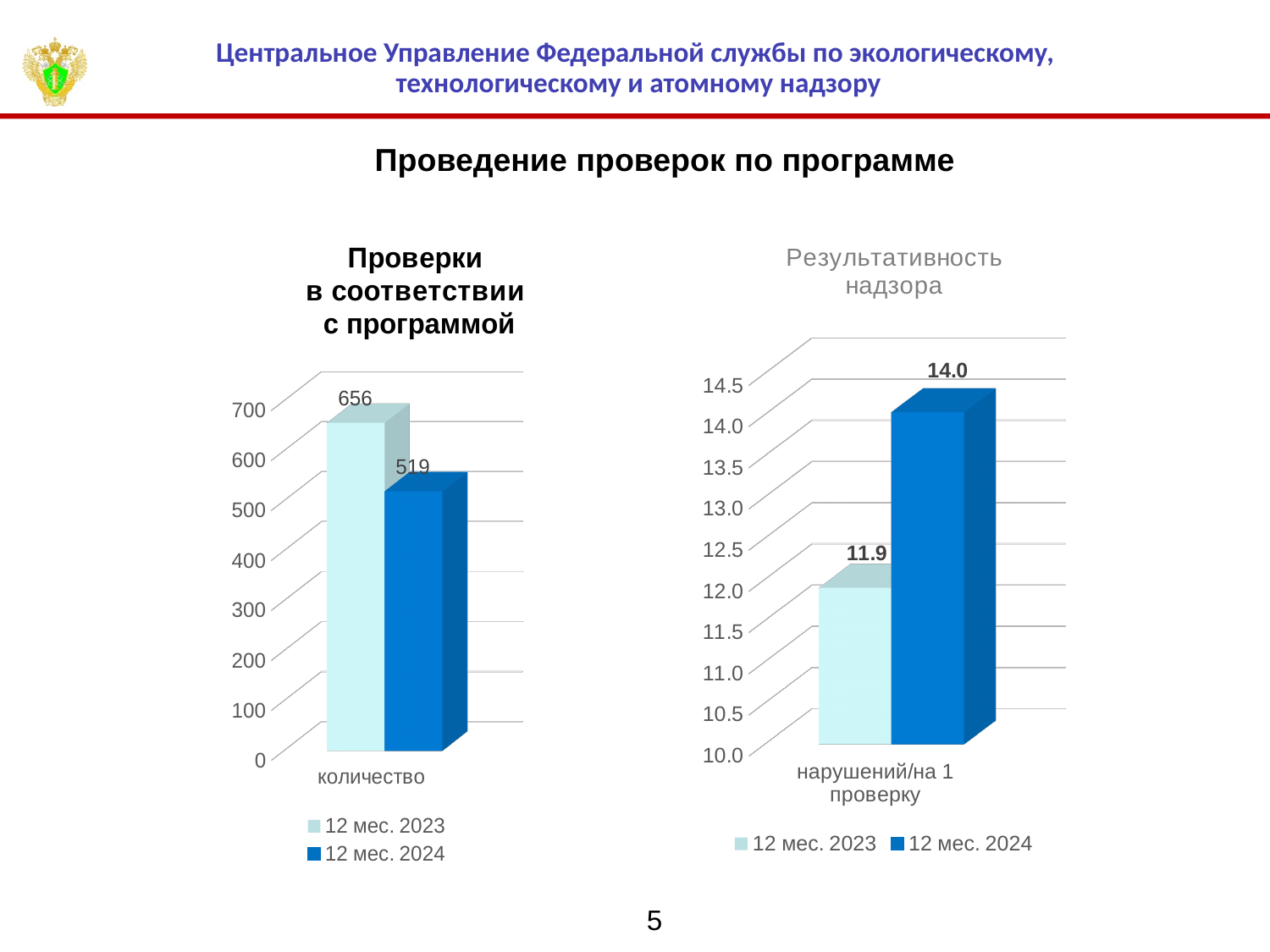
In the chart 'Результативность надзора', what is the value for 12 мес. 2023? 11.9 In the chart 'Проверки в соответствии с программой', what is the difference between the 12 мес. 2023 and 12 мес. 2024 values? 137 In the chart 'Результативность надзора', what is the difference between the 12 мес. 2024 and 12 мес. 2023 values? 2.1 In the chart 'Результативность надзора', which series has the higher value? 12 мес. 2024 In the chart 'Результативность надзора', is the value for 12 мес. 2023 greater or less than 12.0? less What is the category label on the x axis of the chart 'Результативность надзора'? нарушений/на 1 проверку In the chart 'Проверки в соответствии с программой', which series has the higher value, 12 мес. 2023 or 12 мес. 2024? 12 мес. 2023 In the chart 'Результативность надзора', what is the value for 12 мес. 2024? 14.0 What kind of chart is 'Результативность надзора'? bar chart In the chart 'Проверки в соответствии с программой', what is the value for 12 мес. 2024? 519 How many series does the legend of the chart 'Проверки в соответствии с программой' list? 2 In the chart 'Проверки в соответствии с программой', what is the value for 12 мес. 2023? 656